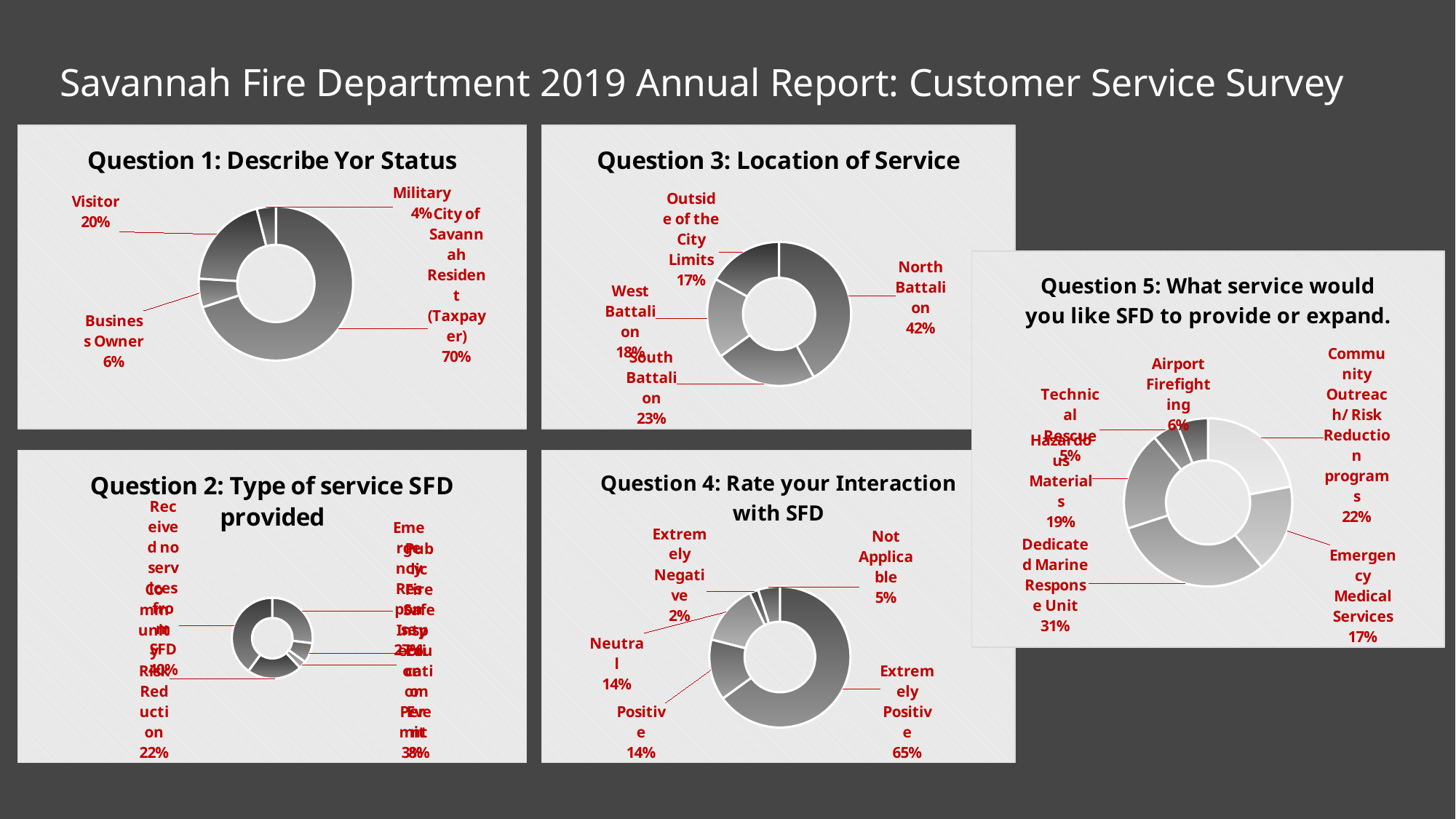
What kind of chart is used for 'Question 1: Describe Yor Status'? Doughnut chart In the 'Question 4: Rate your Interaction with SFD' chart, which is larger: Not Applicable or Neutral? Neutral In the 'Question 1: Describe Yor Status' chart, which category has the smallest share? Military In the 'Question 4: Rate your Interaction with SFD' chart, what percentage is shown for Extremely Positive? 65% In the 'Question 3: Location of Service' chart, what percentage is shown for North Battalion? 42% In the 'Question 1: Describe Yor Status' chart, which category has the largest share? City of Savannah Resident (Taxpayer) In the 'Question 5: What service would you like SFD to provide or expand.' chart, what is the difference between Community Outreach/Risk Reduction programs and Emergency Medical Services? 5% In the 'Question 3: Location of Service' chart, what is the difference between the South Battalion and West Battalion percentages? 5% In the 'Question 1: Describe Yor Status' chart, what percentage is shown for Visitor? 20% In the 'Question 5: What service would you like SFD to provide or expand.' chart, what percentage is shown for Dedicated Marine Response Unit? 31% In the 'Question 4: Rate your Interaction with SFD' chart, which category has the smallest share? Extremely Negative In the 'Question 3: Location of Service' chart, how many categories are shown? 4